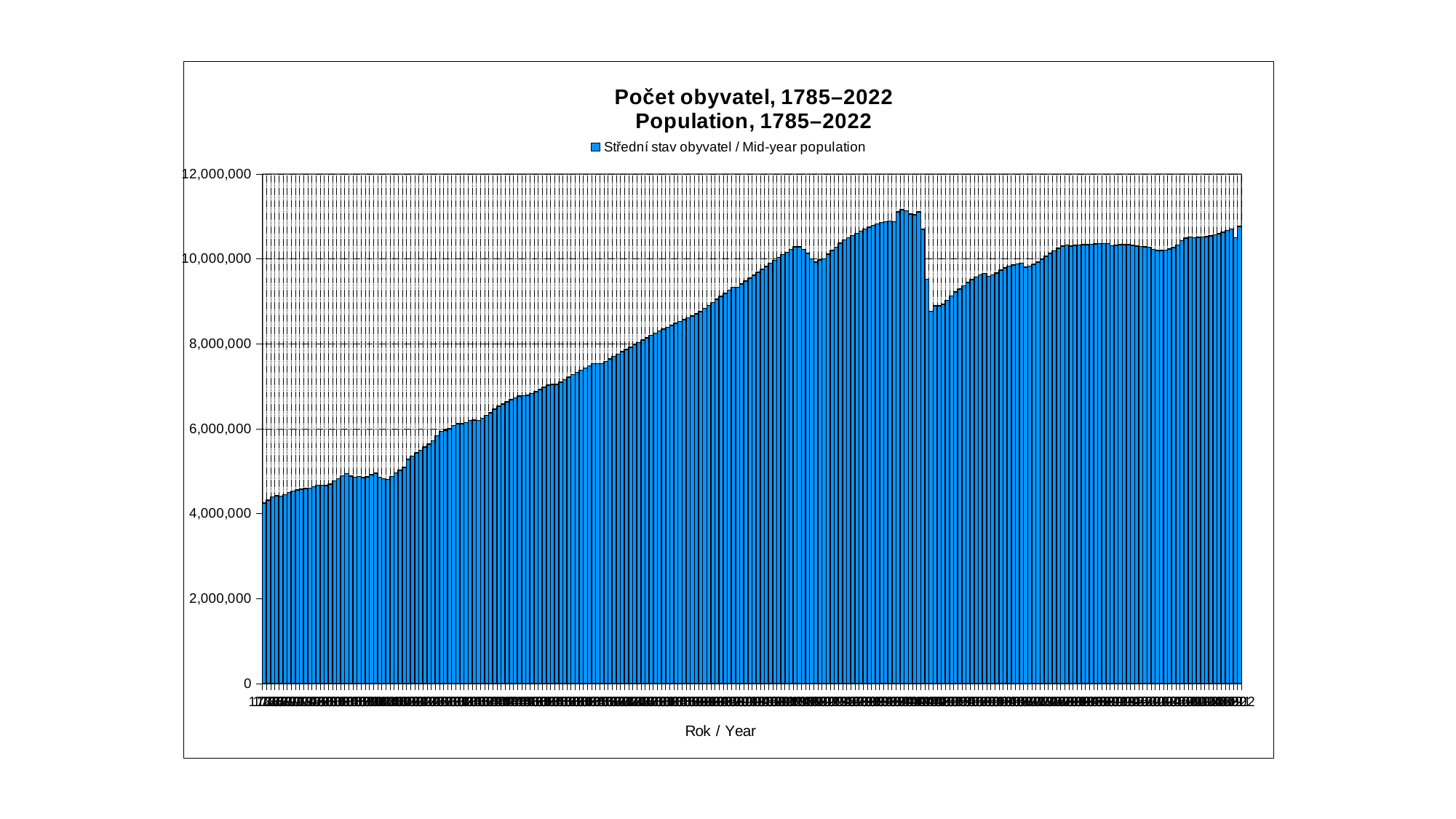
Is the highest bar in the chart greater or less than 10,000,000? greater Is the value for the last year (2022) greater or less than 12,000,000? less Is the value for the last year (2022) greater or less than 10,000,000? greater Which is larger, the value for 1785 or the value for 2022? 2022 How many series does the legend list? 1 What is the title of the chart? Počet obyvatel, 1785–2022 Population, 1785–2022 Do the values generally rise or fall from left to right along the x axis? rise What kind of chart is shown on the slide? bar chart What is the label of the x axis? Rok / Year